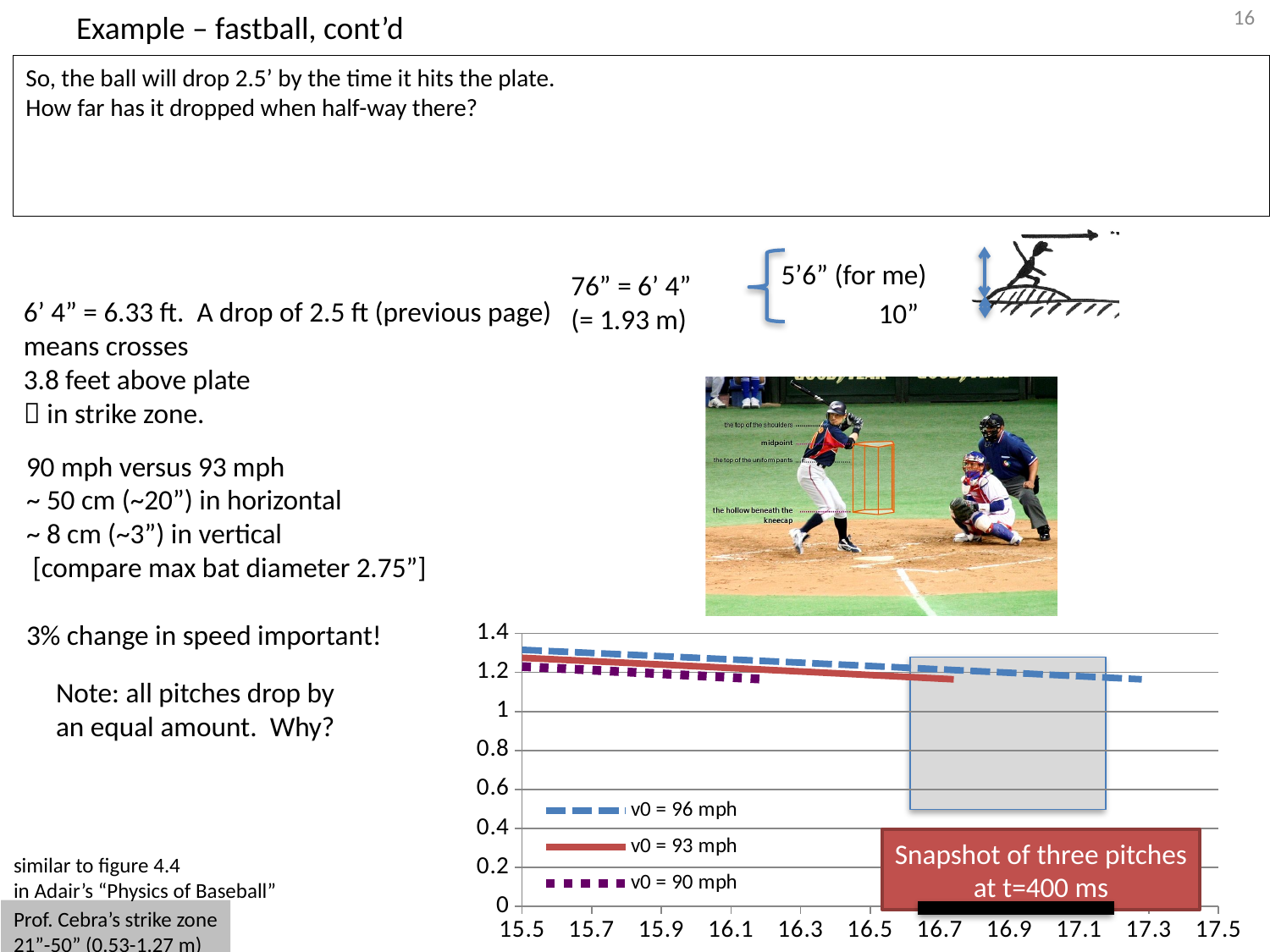
Which series is drawn as a solid red line in the chart? v0 = 93 mph Is the value of the v0 = 90 mph series at x = 16.1 greater or less than 1.4? less Which series extends furthest along the x axis in the chart? v0 = 96 mph What is the highest value shown on the chart's y axis? 1.4 Which series is drawn as a blue dashed line in the chart? v0 = 96 mph Do the values of the v0 = 90 mph series rise or fall as x increases? fall What kind of chart is shown at the bottom right of the slide? line chart Is the value of the v0 = 93 mph series at x = 16.5 greater or less than 1? greater At x = 15.5, which series has the larger value, v0 = 96 mph or v0 = 90 mph? v0 = 96 mph How many series does the chart legend list? 3 Do the values of the v0 = 96 mph series rise or fall as x increases? fall Is the value of the v0 = 96 mph series at x = 15.5 greater or less than 1.2? greater